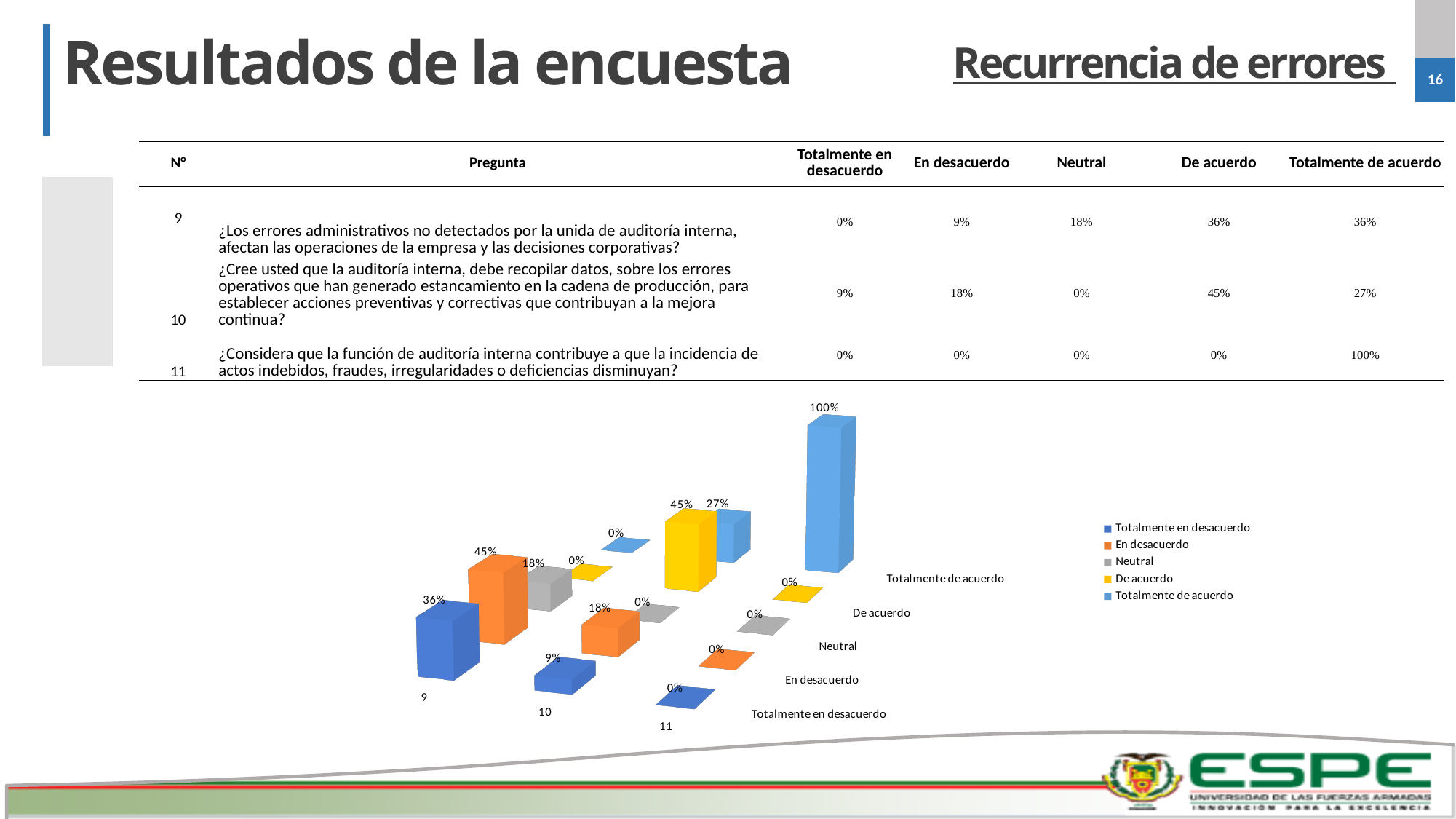
For question 10, which is larger in the chart: De acuerdo or En desacuerdo? De acuerdo In the chart, what is the value for question 10 in the Totalmente de acuerdo series? 27% How many question numbers are plotted along the x axis of the chart? 3 In the chart, what is the difference between the De acuerdo and Totalmente de acuerdo values for question 10? 18% What kind of chart is shown on the slide? bar chart Which bar is the tallest in the chart? Question 11, Totalmente de acuerdo In the chart, what is the value for question 10 in the De acuerdo series? 45% Which series is listed first in the chart legend? Totalmente en desacuerdo In the chart, what is the value for question 10 in the Totalmente en desacuerdo series? 9% How many series does the chart legend list? 5 What colour represents the Neutral series in the chart legend? gray In the chart, what is the value for question 11 in the Totalmente de acuerdo series? 100%